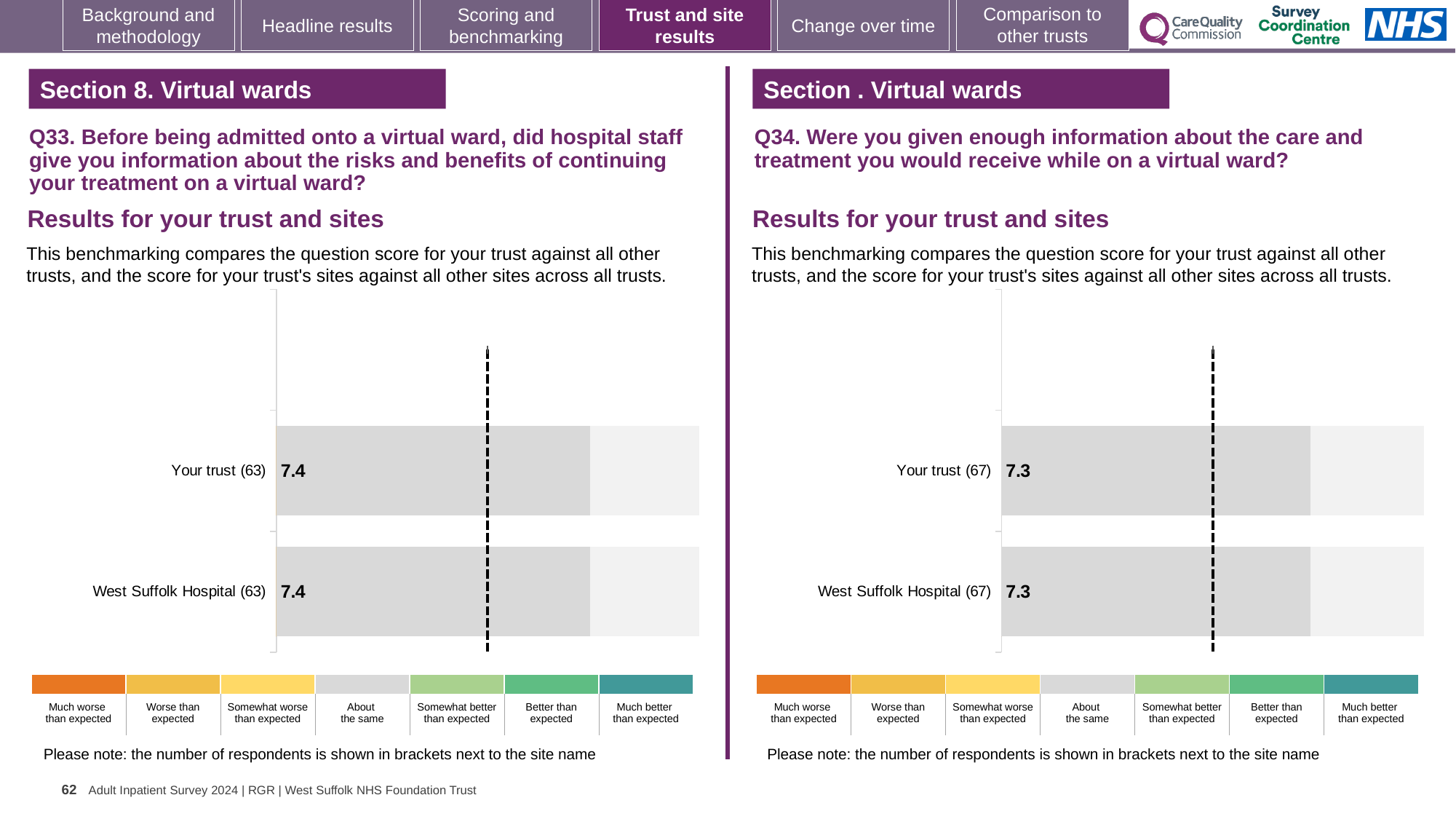
On the Q34 chart (right), how many bars are plotted? 2 On the Q33 chart (left), which benchmark category does the grey colour of the bars correspond to in the legend? About the same On the Q33 chart (left), what is the difference between the score for Your trust and the score for West Suffolk Hospital? 0 What kind of chart is used on the Q33 chart (left)? Bar chart On the Q34 chart (right), what is the score for West Suffolk Hospital? 7.3 On the Q33 chart (left), how many respondents are shown in brackets for Your trust? 63 How many categories does the colour legend below the Q34 chart (right) list? 7 On the Q33 chart (left), what is the score for West Suffolk Hospital? 7.4 On the Q33 chart (left), what is the score for Your trust? 7.4 On the Q34 chart (right), what is the score for Your trust? 7.3 On the Q34 chart (right), is the score for Your trust greater or less than the score for Your trust on the Q33 chart (left)? less On the Q34 chart (right), how many respondents are shown in brackets for West Suffolk Hospital? 67